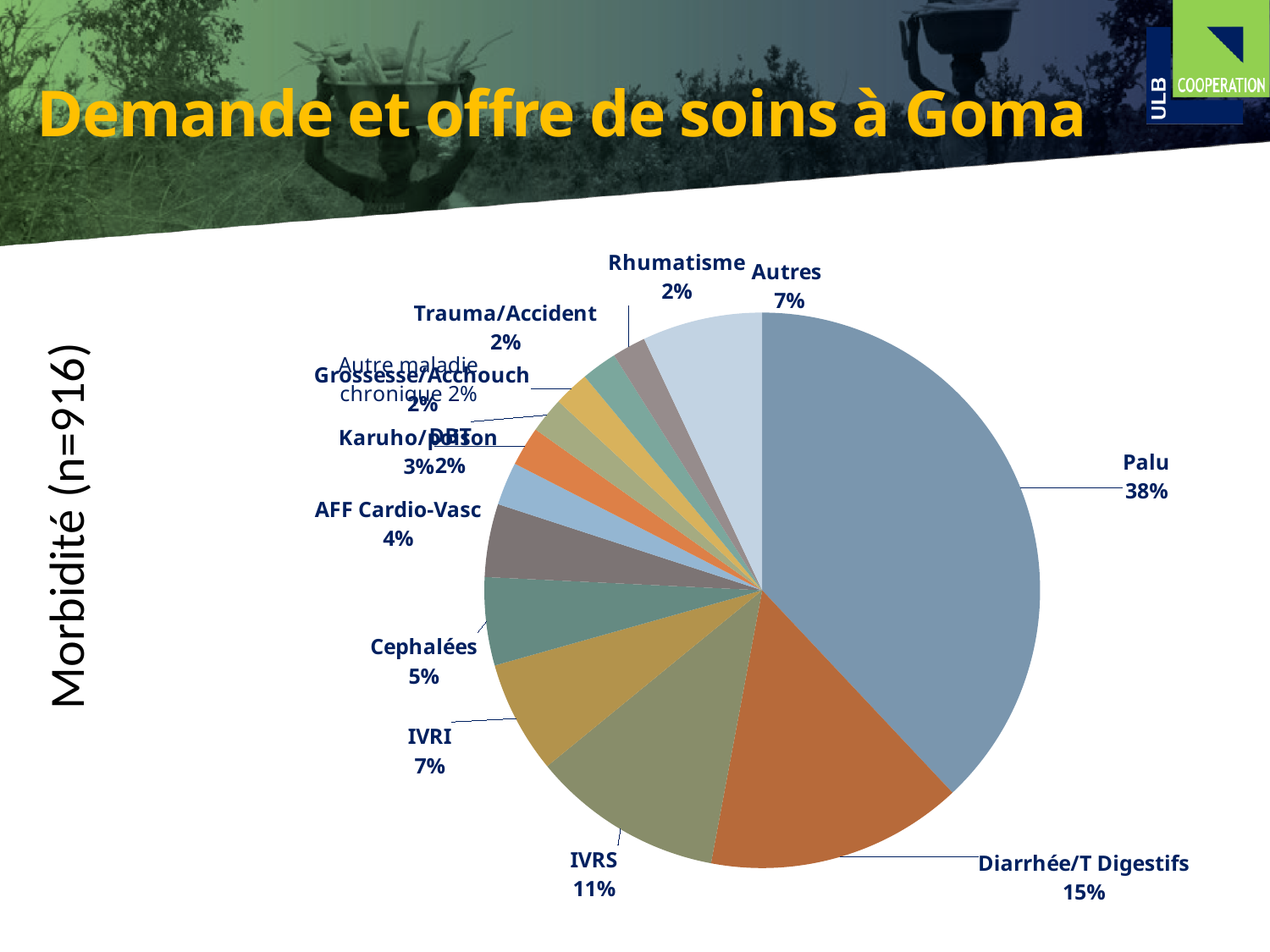
Which category has the largest slice of the pie? Palu What percentage is shown for Diarrhée/T Digestifs? 15% Which is larger, the share for IVRS or the share for IVRI? IVRS What is the value for Cephalées? 5% What is the value for Autres? 7% What kind of chart is shown on the slide? pie chart What is the difference between the Palu share and the Diarrhée/T Digestifs share? 23% What percentage is shown for IVRI? 7% What is the sample size stated in the label next to the chart? n=916 What percentage is shown for AFF Cardio-Vasc? 4% What share of the pie does Palu represent? 38% What is the value for IVRS? 11%